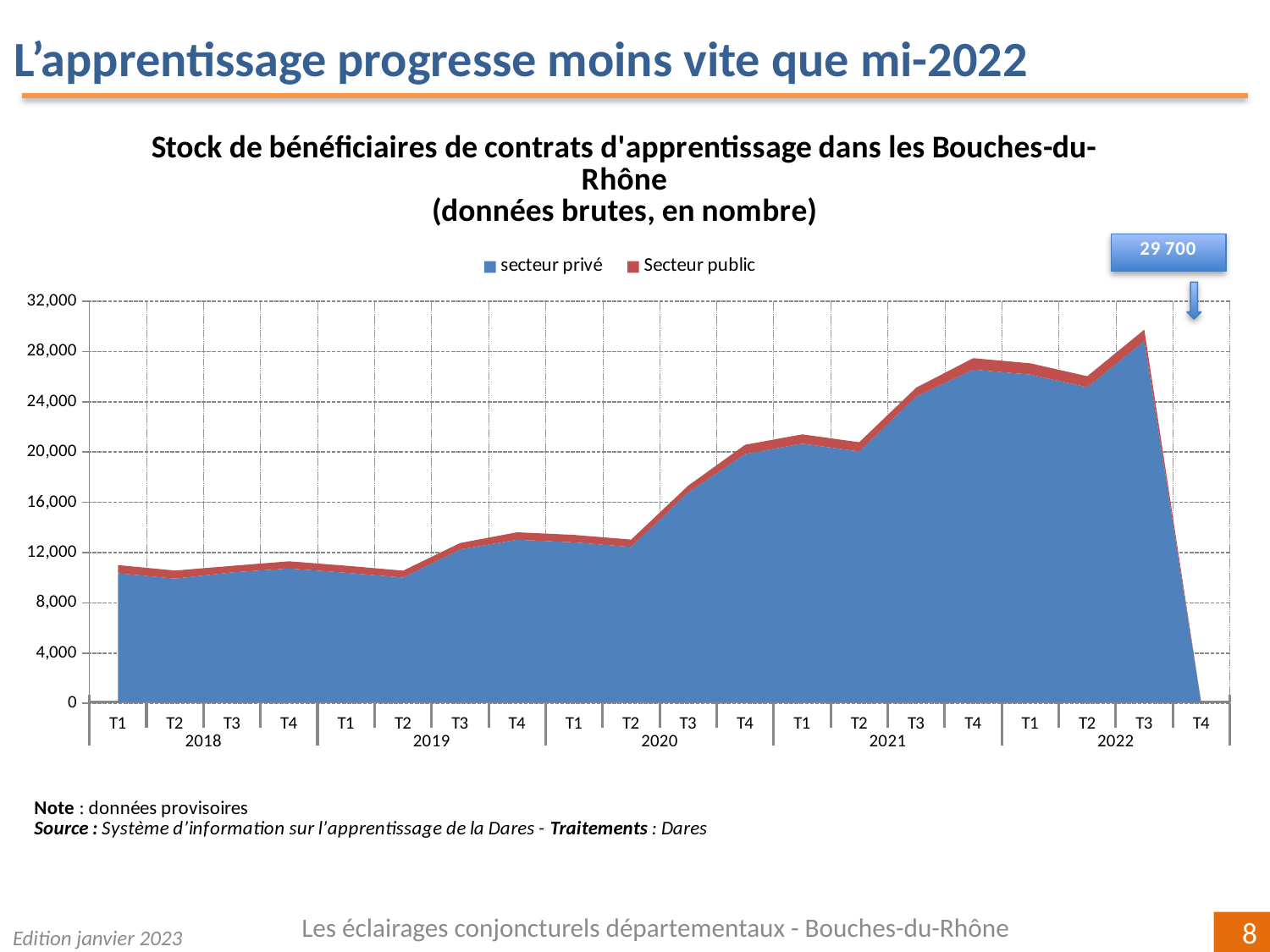
What value is shown in the callout box at the top right of the chart? 29 700 Which quarter shows the highest total stock of apprenticeship contracts? T3 2022 Is the total stock in T4 2021 greater or less than 24,000? greater How many series does the legend list? 2 What kind of chart is shown on the slide? area chart Which is larger, the total stock in T1 2021 or in T1 2020? T1 2021 Does the total stock generally rise or fall from T1 2018 to T3 2022? rise Is the total stock in T1 2018 greater or less than 12,000? less Is the total stock in T2 2020 greater or less than 16,000? less What are the two series named in the legend? secteur privé and Secteur public Which series accounts for the larger share of the stock, secteur privé or Secteur public? secteur privé